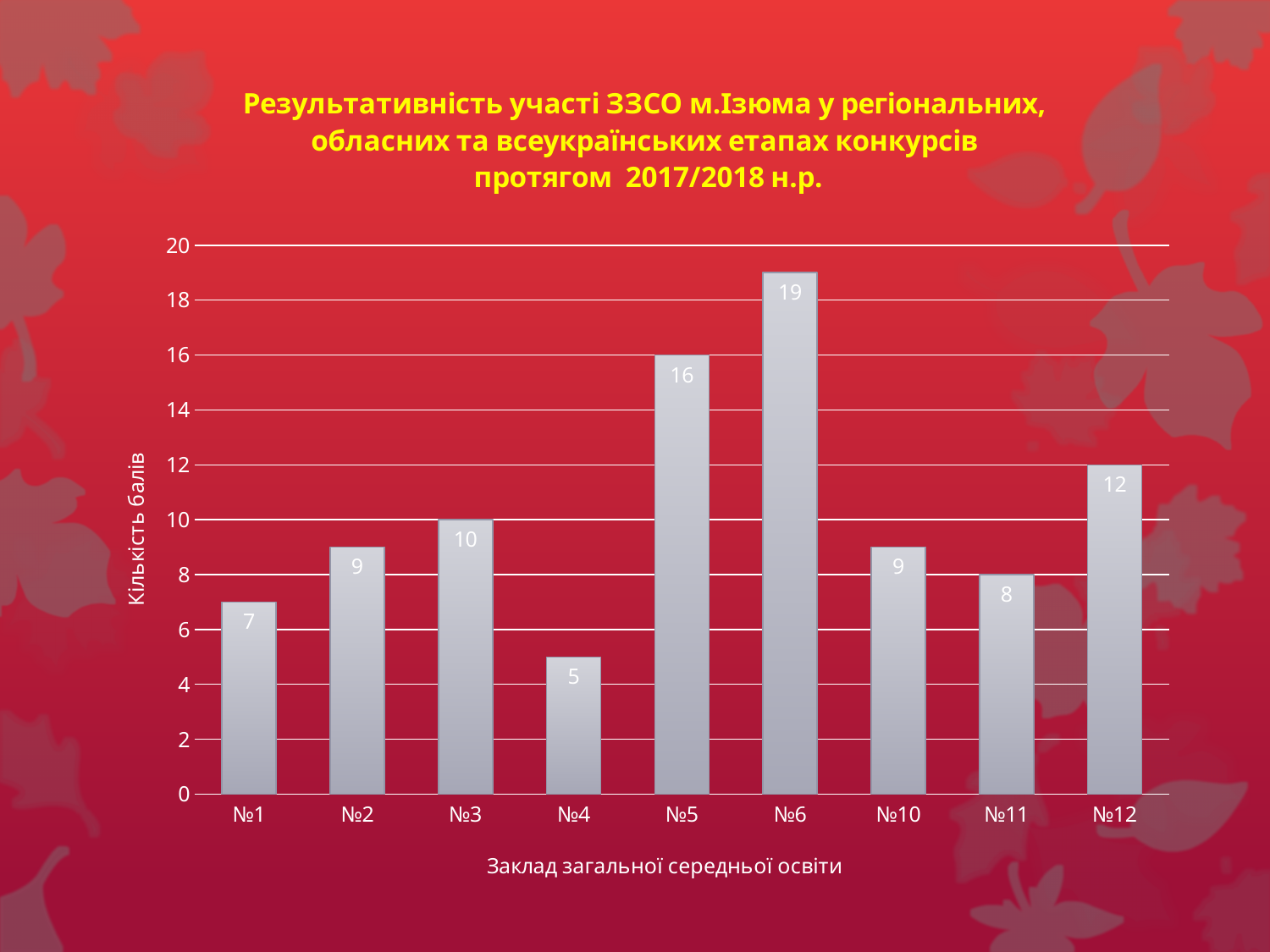
What is the label of the x axis? Заклад загальної середньої освіти Which category has the highest value? №6 Which is larger, the value for №11 or the value for №12? №12 What is the difference between the values for №6 and №5? 3 What is the value for №12? 12 What is the value for №6? 19 What is the value for №4? 5 What kind of chart is this? bar chart How many categories are shown on the x axis? 9 What is the difference between the values for №3 and №1? 3 What is the label of the y axis? Кількість балів Which category has the lowest value? №4